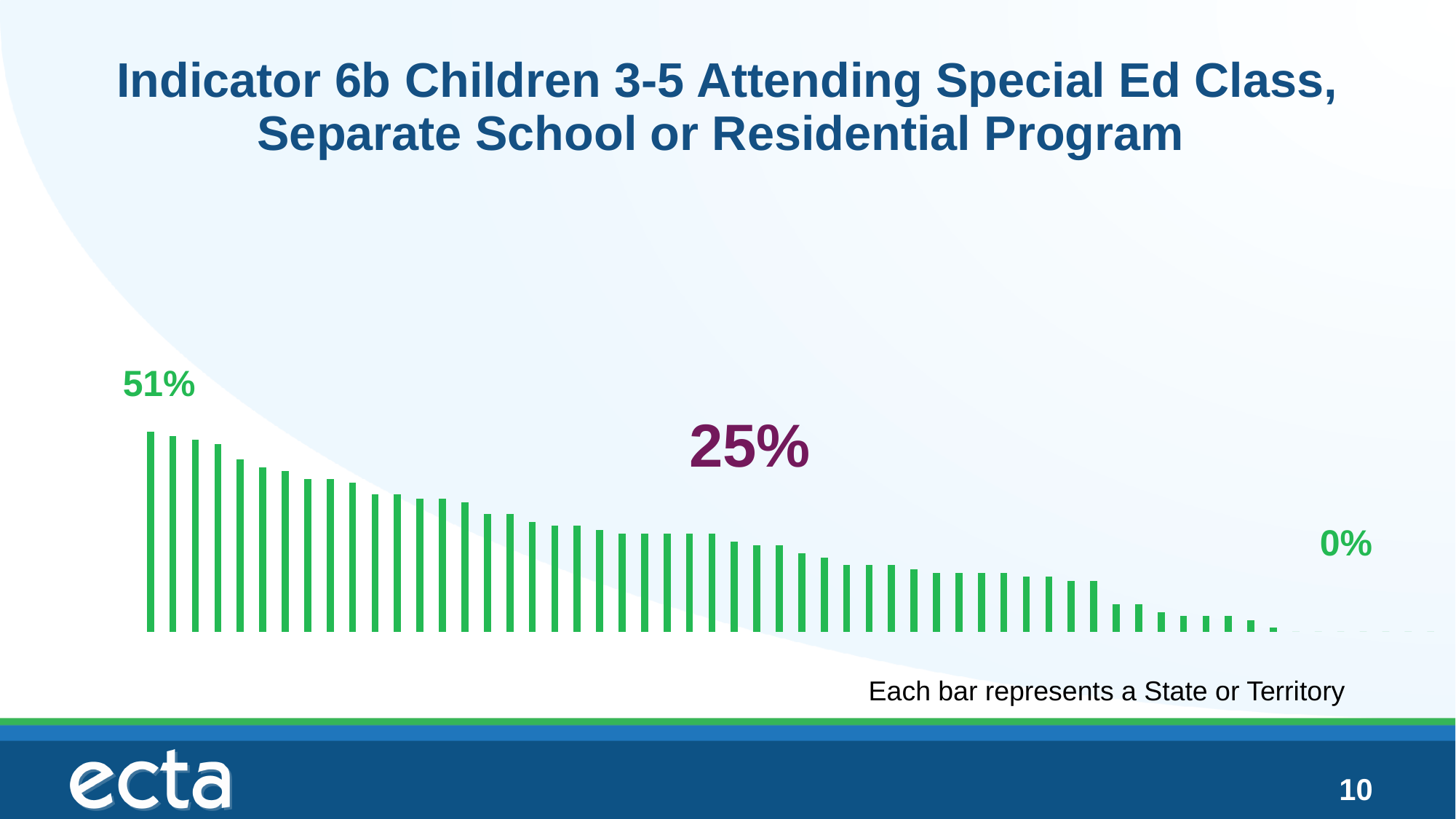
Which bar is larger, the leftmost bar or the rightmost bar? the leftmost bar Do the bar values rise or fall from left to right across the chart? fall What is the difference between the highest value (51%) and the lowest value (0%) on the chart? 51% What is the lowest value shown on the chart? 0% Is the value of the rightmost bar greater or less than 25%? less Is the value of the leftmost bar greater or less than 25%? greater What value is printed in large purple text in the middle of the chart? 25% What is the highest value shown on the chart? 51% According to the note on the slide, what does each bar represent? a State or Territory What kind of chart is shown on the slide? bar chart